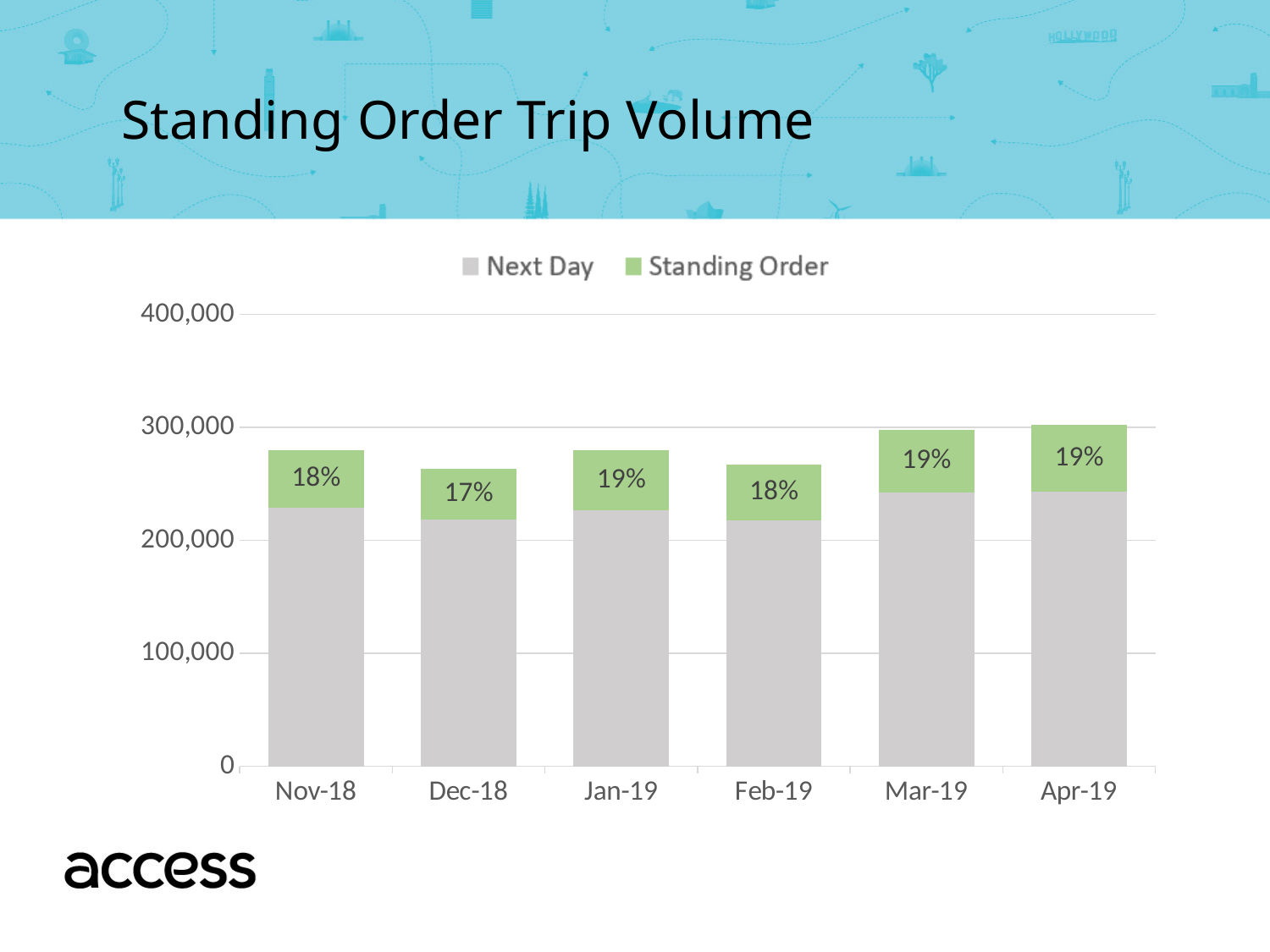
How many series does the legend list? 2 What kind of chart is shown on the slide? Stacked bar chart Is the total bar height for Nov-18 greater or less than 300,000? less What percentage label is shown on the Standing Order segment for Apr-19? 19% What percentage label is shown on the Standing Order segment for Dec-18? 17% Which month has the lowest Standing Order percentage label? Dec-18 Which month has the taller total bar, Mar-19 or Dec-18? Mar-19 What colour represents the Standing Order series in the legend? Green What percentage label is shown on the Standing Order segment for Nov-18? 18% What is the title of the slide? Standing Order Trip Volume How many months are shown on the x axis? 6 Is the total bar height for Dec-18 greater or less than 200,000? greater